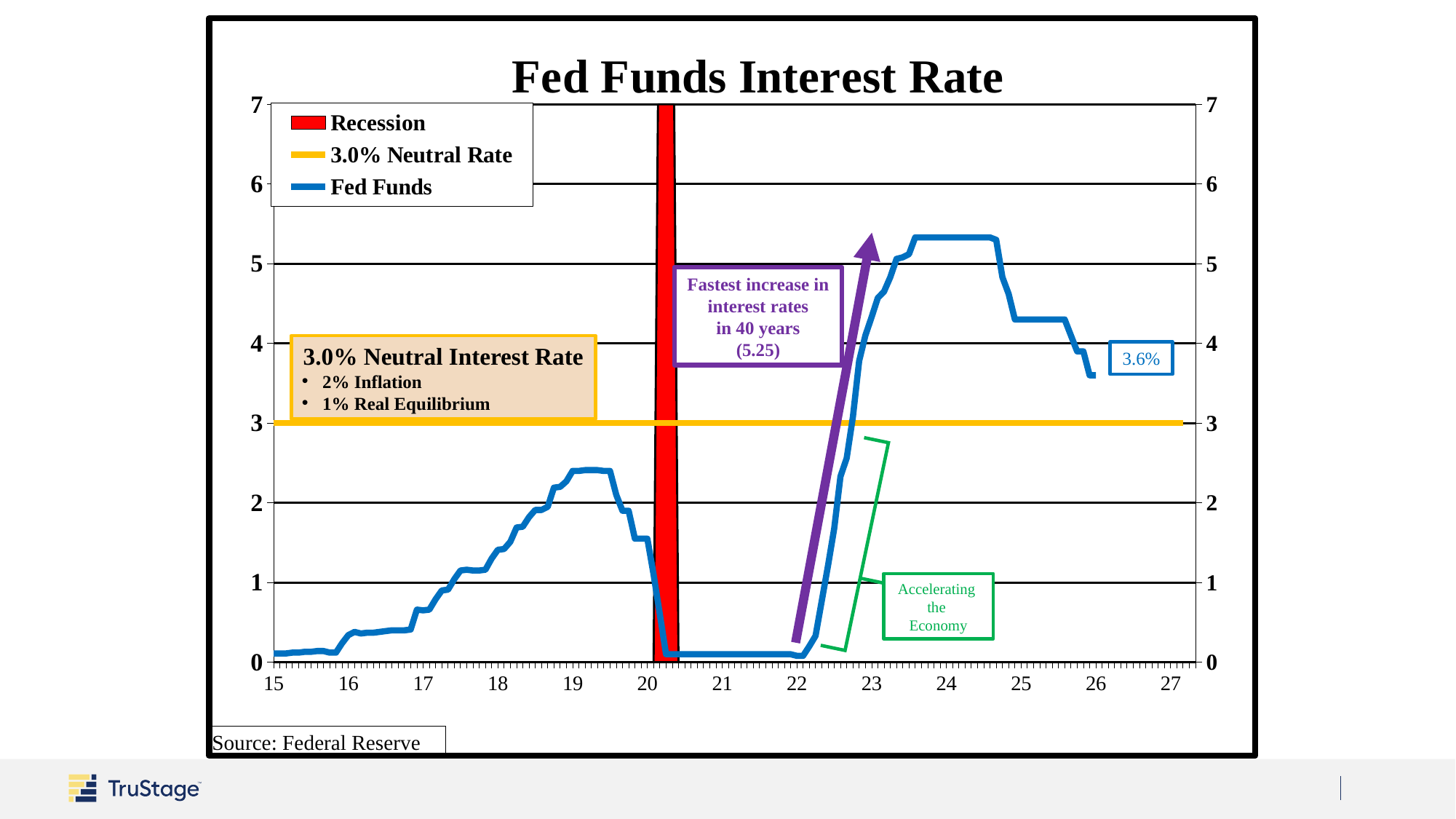
What value does the yellow horizontal Neutral Rate line represent? 3.0% According to the annotation, what was the size of the fastest increase in interest rates in 40 years? 5.25 What source is cited for the chart data? Federal Reserve How many entries does the chart legend list? 3 Which is higher: the Fed Funds peak around 19 or the Fed Funds peak around 24? the peak around 24 What Fed Funds value is labeled at the end of the blue line near 26? 3.6% Is the Fed Funds value at 24 greater or less than 5? greater What is the title of the chart? Fed Funds Interest Rate Is the Fed Funds peak around 19 greater or less than 3? less Does the Fed Funds line rise or fall between 22 and 23? rise Is the Fed Funds value at 21 greater or less than 1? less What kind of chart is shown on the slide? line chart